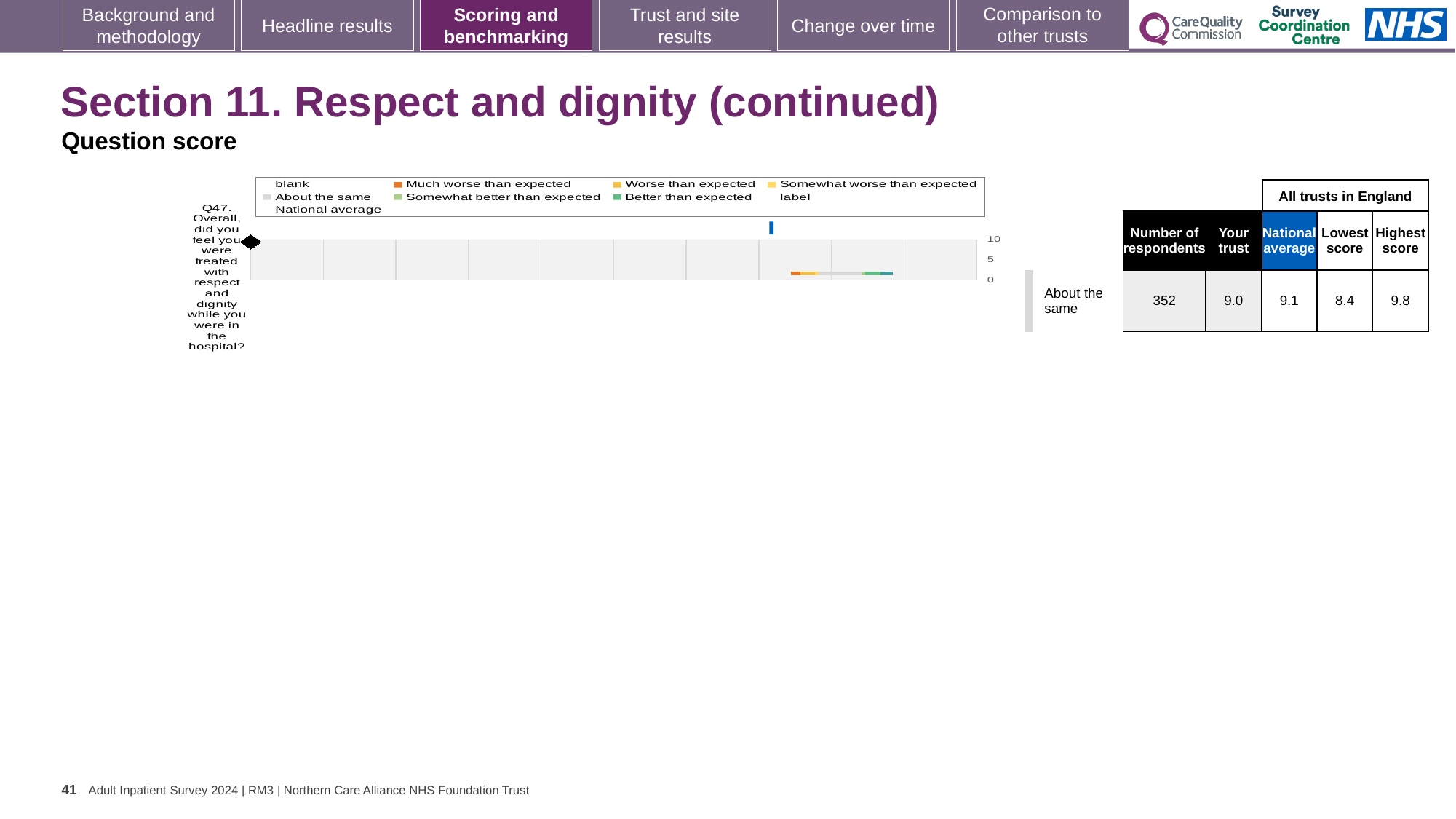
Which is larger for Q47, the trust's score or the national average? National average What is the trust's score for Q47 shown alongside the chart? 9.0 Is the trust's score for Q47 greater or less than 5 on the chart's axis? greater How many questions are plotted on the chart? 1 Which legend entry is shown with an orange marker? Much worse than expected What is the difference between the highest and lowest scores among all trusts in England for Q47? 1.4 What is the national average score for Q47 shown alongside the chart? 9.1 What is the highest score among all trusts in England for Q47? 9.8 How many respondents answered Q47? 352 What is the lowest score among all trusts in England for Q47? 8.4 What benchmarking category is the trust's Q47 result placed in? About the same What is the highest value shown on the chart's axis? 10